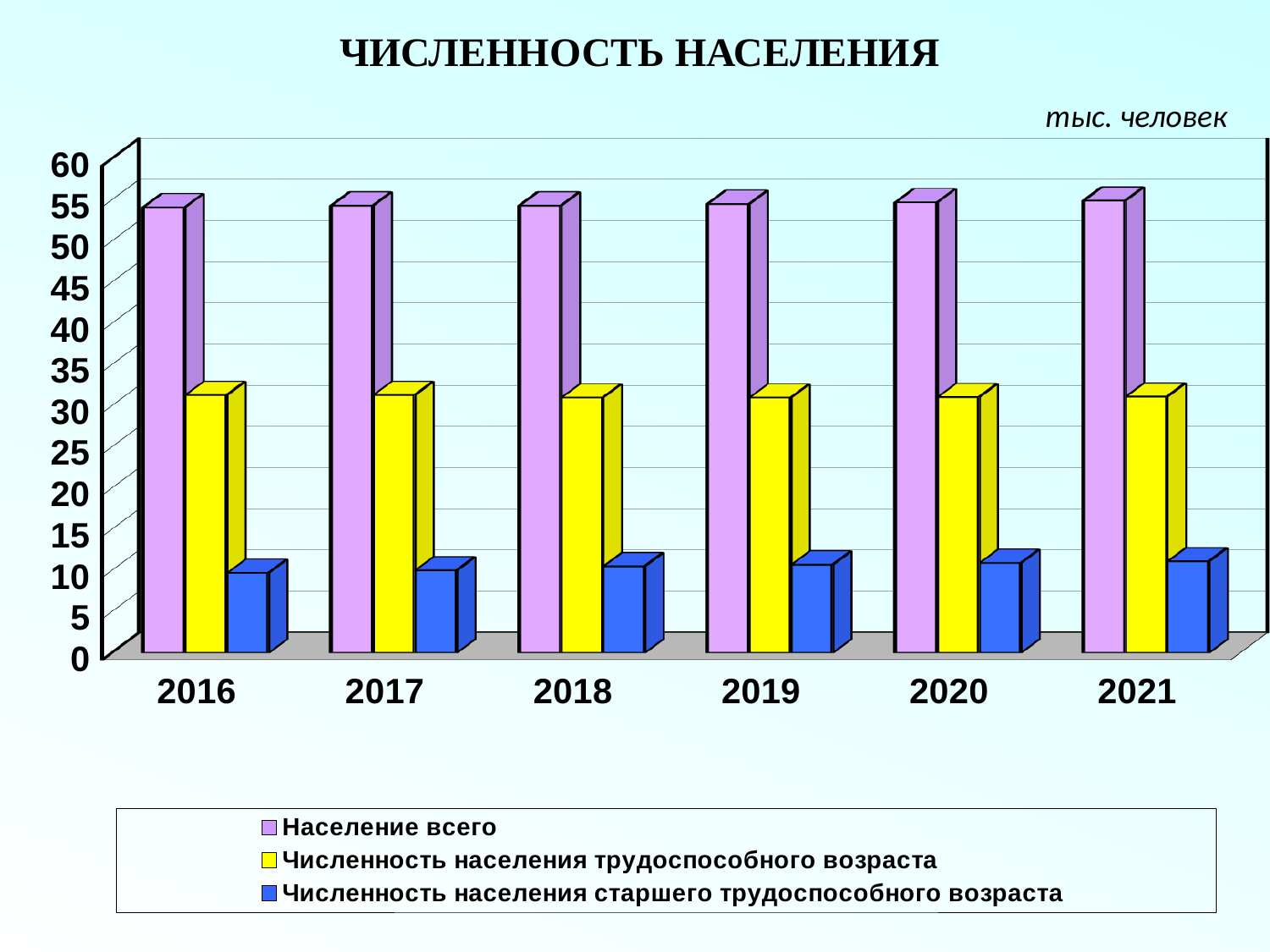
Which series has the lowest values across all years? Численность населения старшего трудоспособного возраста Is the value for Численность населения старшего трудоспособного возраста in 2016 greater or less than 15? less How many series does the legend list? 3 Is the value for Численность населения трудоспособного возраста in 2018 greater or less than 25? greater What is the title of the chart? ЧИСЛЕННОСТЬ НАСЕЛЕНИЯ How many years are shown on the x axis of the chart? 6 What kind of chart is shown on the slide? bar chart What unit is indicated for the values in the chart? тыс. человек Is the value for Численность населения трудоспособного возраста in 2021 greater or less than 40? less In 2019, which is larger: Население всего or Численность населения трудоспособного возраста? Население всего